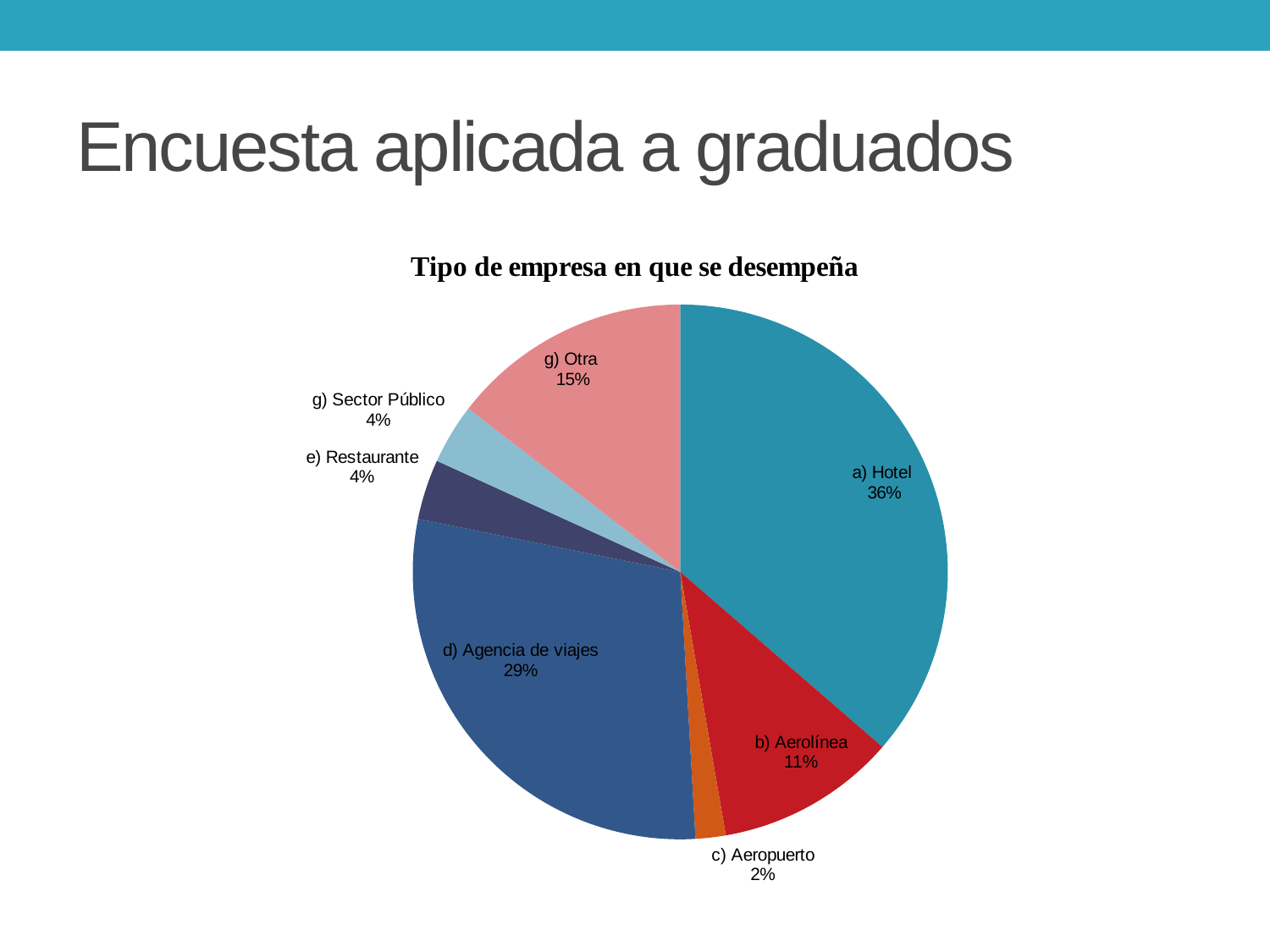
What is the difference in percentage points between a) Hotel and d) Agencia de viajes? 7 What is the title of the chart? Tipo de empresa en que se desempeña How many slices does the pie chart have? 7 Which category has the smallest slice of the pie? c) Aeropuerto What share of the pie does d) Agencia de viajes represent? 29% What share of the pie does b) Aerolínea represent? 11% Which is larger, the share for g) Otra or the share for b) Aerolínea? g) Otra What share of the pie does g) Otra represent? 15% Which category has the largest slice of the pie? a) Hotel What share of the pie does a) Hotel represent? 36% What type of chart is shown on the slide? pie chart What share of the pie does c) Aeropuerto represent? 2%